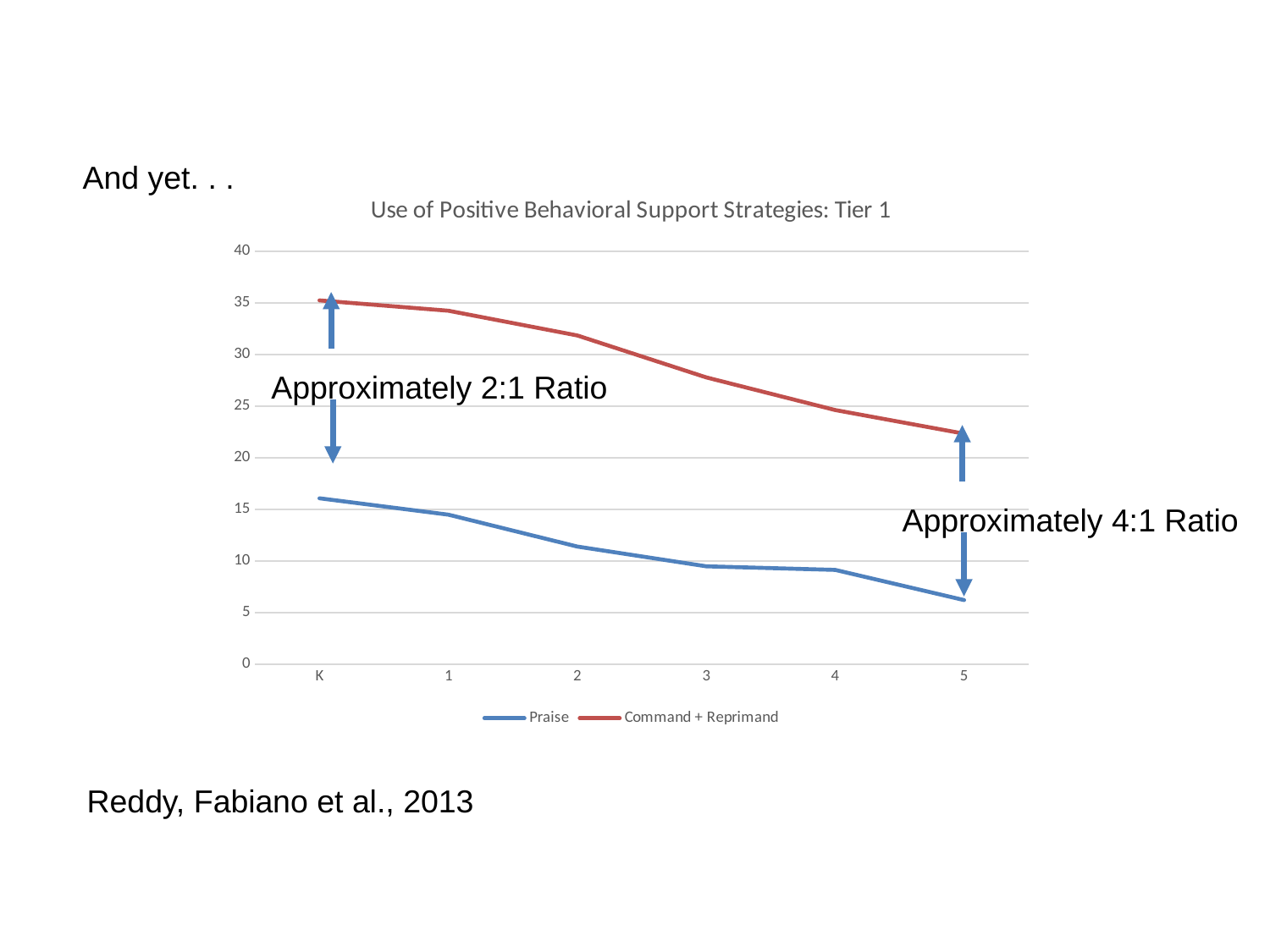
Do the Praise values rise or fall from K to 5? fall At grade 2, which series has the larger value, Praise or Command + Reprimand? Command + Reprimand How many grade-level categories are shown on the x axis? 6 Is the Command + Reprimand value at K greater or less than 30? greater Do the Command + Reprimand values rise or fall from K to 5? fall How many series does the legend list? 2 Which series is drawn in red? Command + Reprimand What is the title of the chart? Use of Positive Behavioral Support Strategies: Tier 1 At which grade is the Praise value lowest? 5 What kind of chart is shown on the slide? line chart Is the Praise value at grade 5 greater or less than 10? less At which grade is the Command + Reprimand value highest? K